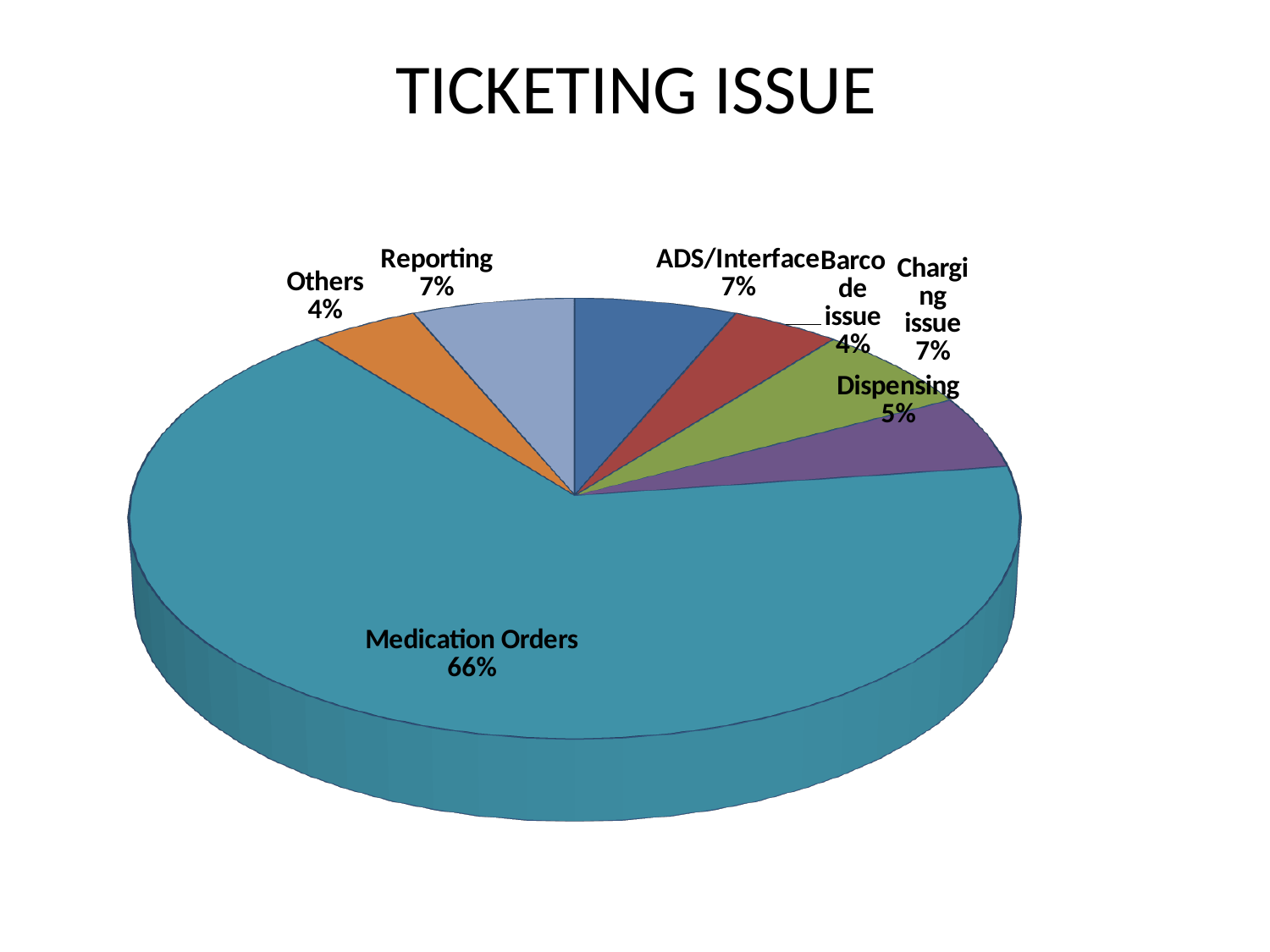
What percentage is shown for Reporting? 7% What kind of chart is shown on the slide? pie chart What is the title of the chart? TICKETING ISSUE What is the difference in percentage points between Medication Orders and ADS/Interface? 59 Which category has the largest slice of the pie? Medication Orders What share of the pie does Medication Orders take? 66% How many slices does the pie chart have? 7 What is the difference in percentage points between Reporting and Others? 3 What percentage is shown for Charging issue? 7% Which is larger, the share for Dispensing or the share for Barcode issue? Dispensing What percentage is shown for Dispensing? 5% What percentage is shown for Barcode issue? 4%